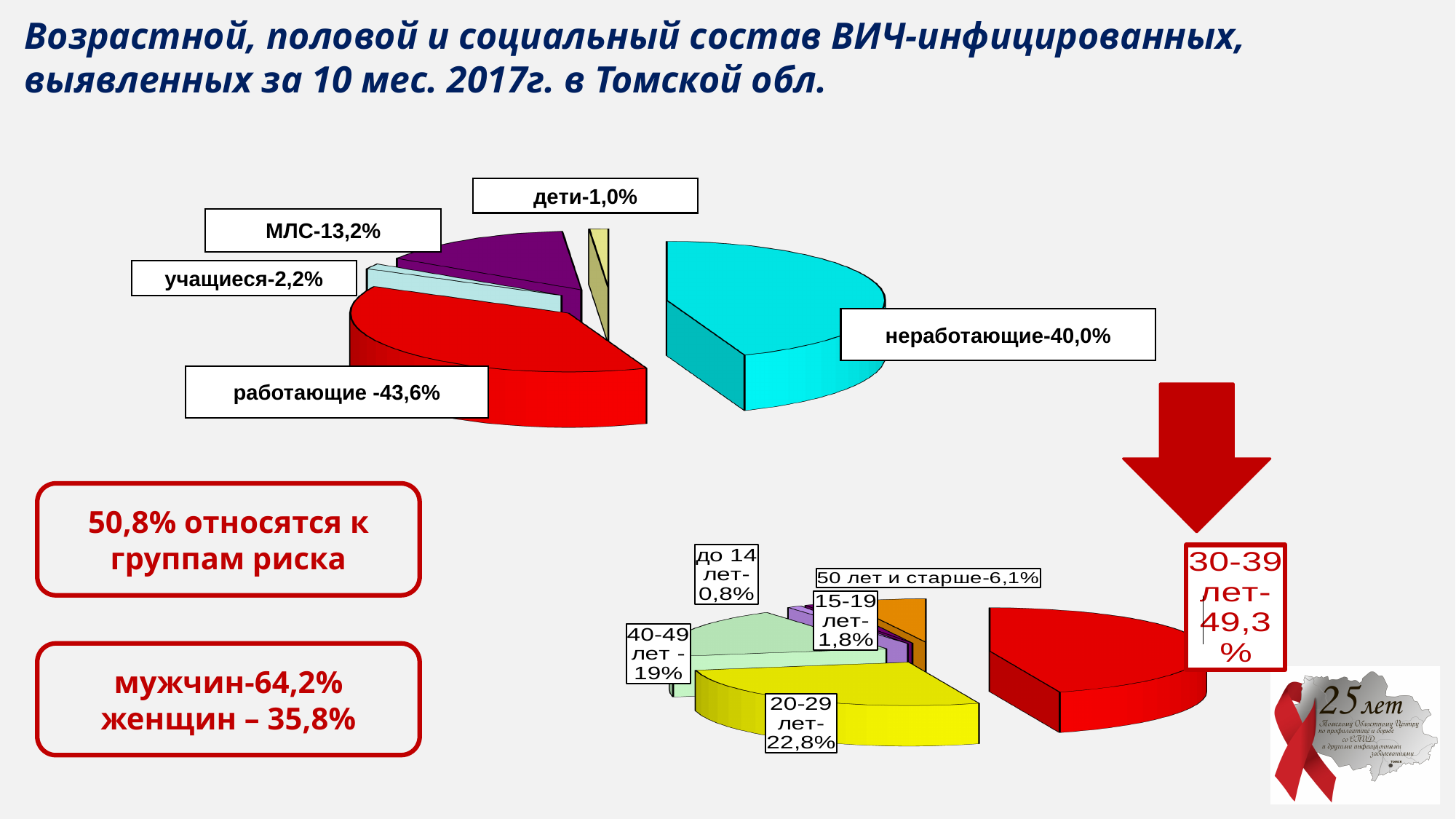
In the lower pie chart (age composition), which is larger: the share for 40-49 лет or for 50 лет и старше? 40-49 лет In the upper pie chart (social composition), which category has the largest share? работающие In the upper pie chart (social composition), what share is labelled for работающие? 43,6% In the lower pie chart (age composition), how many age groups are shown? 6 What type of chart is used for the age composition at the bottom of the slide? Pie chart In the upper pie chart (social composition), what share is labelled for МЛС? 13,2% In the upper pie chart (social composition), what is the difference between the shares of работающие and неработающие? 3,6% In the lower pie chart (age composition), what share is labelled for 20-29 лет? 22,8% In the upper pie chart (social composition), which category has the smallest share? дети In the lower pie chart (age composition), which age group has the smallest share? до 14 лет In the upper pie chart (social composition), how many slices are there? 5 In the lower pie chart (age composition), what share is labelled for 30-39 лет? 49,3%